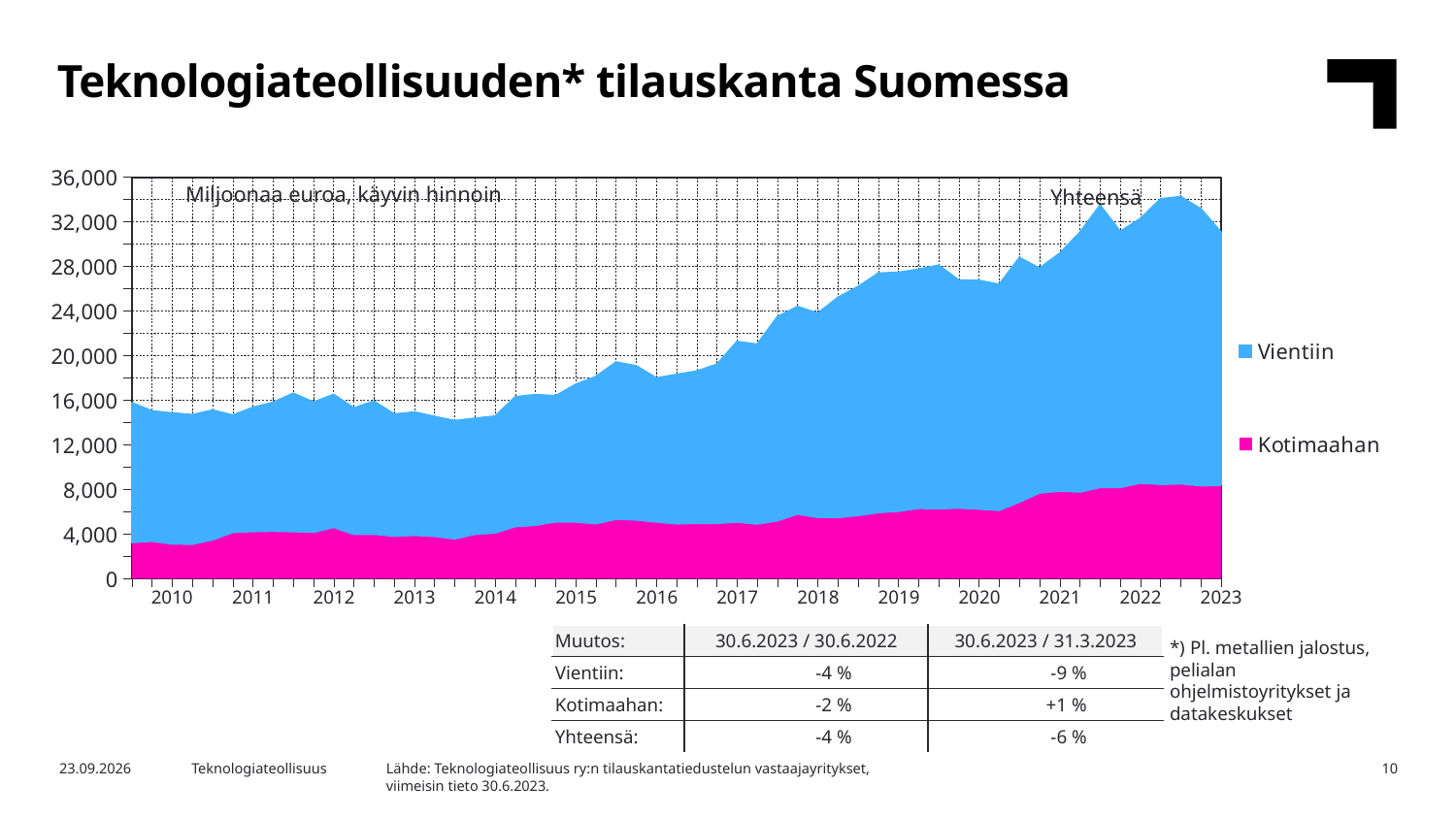
Is the value for Kotimaahan at the start of 2010 greater or less than 4,000? less Is the total (Yhteensä) at its 2022 peak greater or less than 32,000? greater Which series is larger in 2023, Vientiin or Kotimaahan? Vientiin Is the value for Kotimaahan in 2015 greater or less than 4,000? greater How many series does the chart legend list? 2 What are the two series named in the chart legend? Vientiin and Kotimaahan What unit label is printed inside the chart area? Miljoonaa euroa, käyvin hinnoin What kind of chart is shown on the slide? Stacked area chart How many year labels are shown on the x axis? 14 Does the Kotimaahan series generally rise or fall from 2010 to 2023? rise